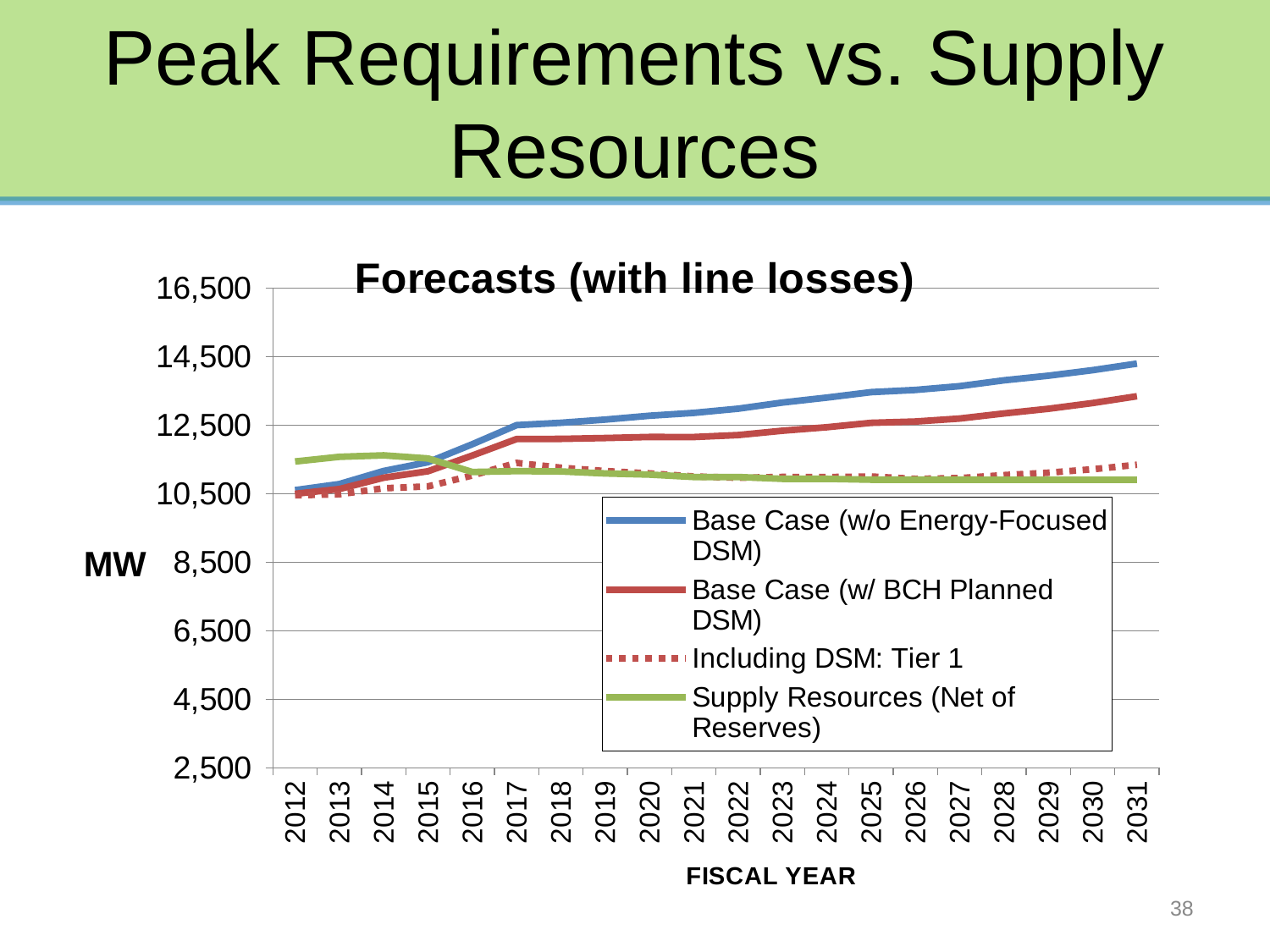
Is the value for Base Case (w/o Energy-Focused DSM) in 2031 greater or less than 12,500? greater Is the value for Supply Resources (Net of Reserves) in 2031 greater or less than 12,500? less Is the value for Including DSM: Tier 1 in 2012 greater or less than 12,500? less What is the title of the chart? Forecasts (with line losses) What kind of chart is shown on the slide? Line chart Does the Supply Resources (Net of Reserves) series rise or fall from 2012 to 2031? Fall What is the label on the x axis? FISCAL YEAR How many series does the legend list? 4 How many fiscal years are shown along the x axis? 20 Which series has the highest value in 2031? Base Case (w/o Energy-Focused DSM) In 2012, which is larger: Supply Resources (Net of Reserves) or Base Case (w/o Energy-Focused DSM)? Supply Resources (Net of Reserves) Does the Base Case (w/o Energy-Focused DSM) series rise or fall from 2012 to 2031? Rise